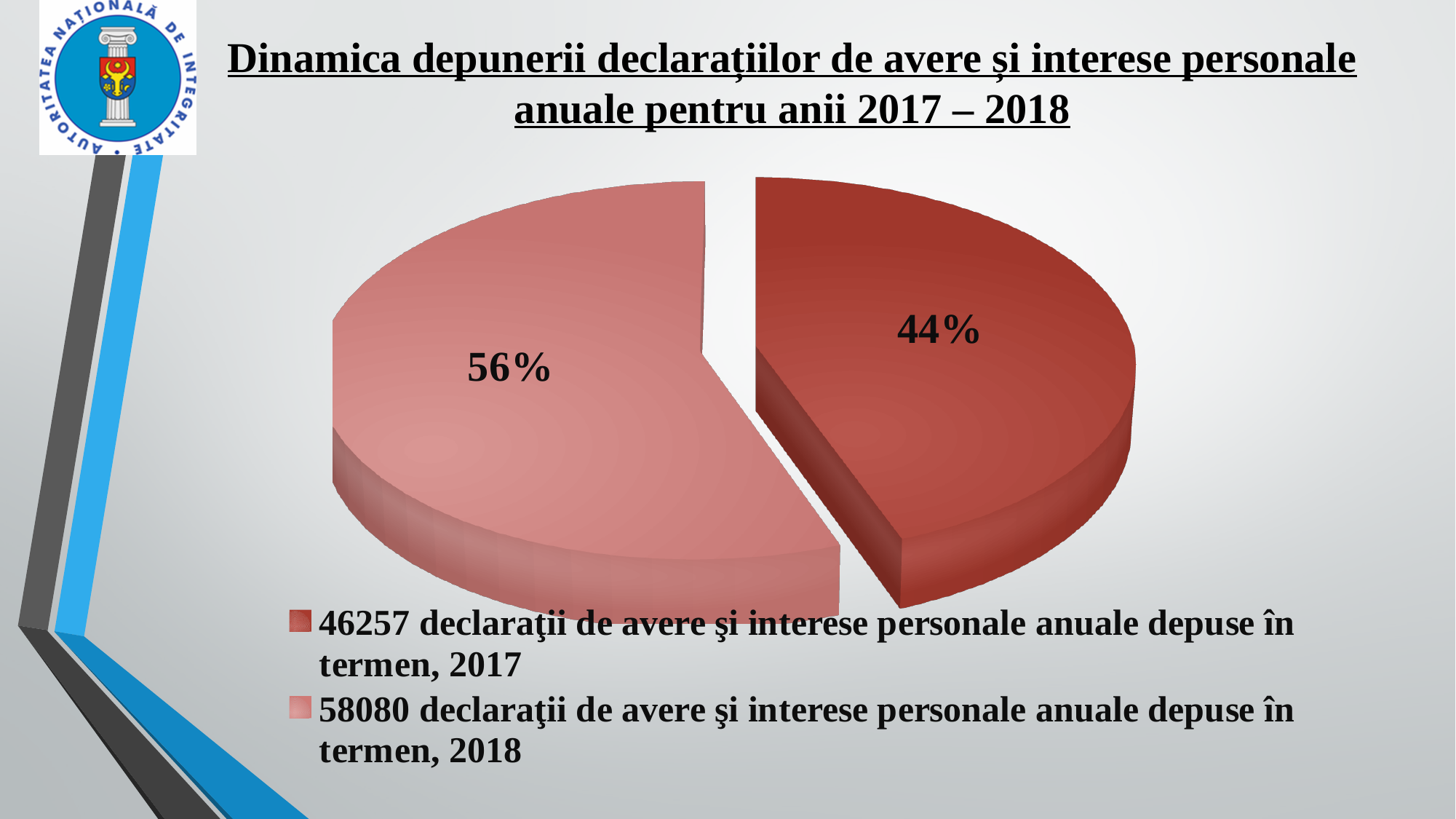
What share of the pie does the 2018 slice (58080 declarations) represent? 56% What is the title of the chart on the slide? Dinamica depunerii declarațiilor de avere și interese personale anuale pentru anii 2017 – 2018 Which slice is the smallest in the pie chart? 2017 (44%) How many entries does the legend list? 2 How many declarations were submitted on time in 2017 according to the legend? 46257 What kind of chart is shown on the slide? pie chart What share of the pie does the 2017 slice (46257 declarations) represent? 44% Which year has the larger slice of the pie, 2017 or 2018? 2018 How many declarations were submitted on time in 2018 according to the legend? 58080 What is the difference in percentage points between the 2018 slice and the 2017 slice? 12 percentage points Which slice is the largest in the pie chart? 2018 (56%) How many slices does the pie chart have? 2